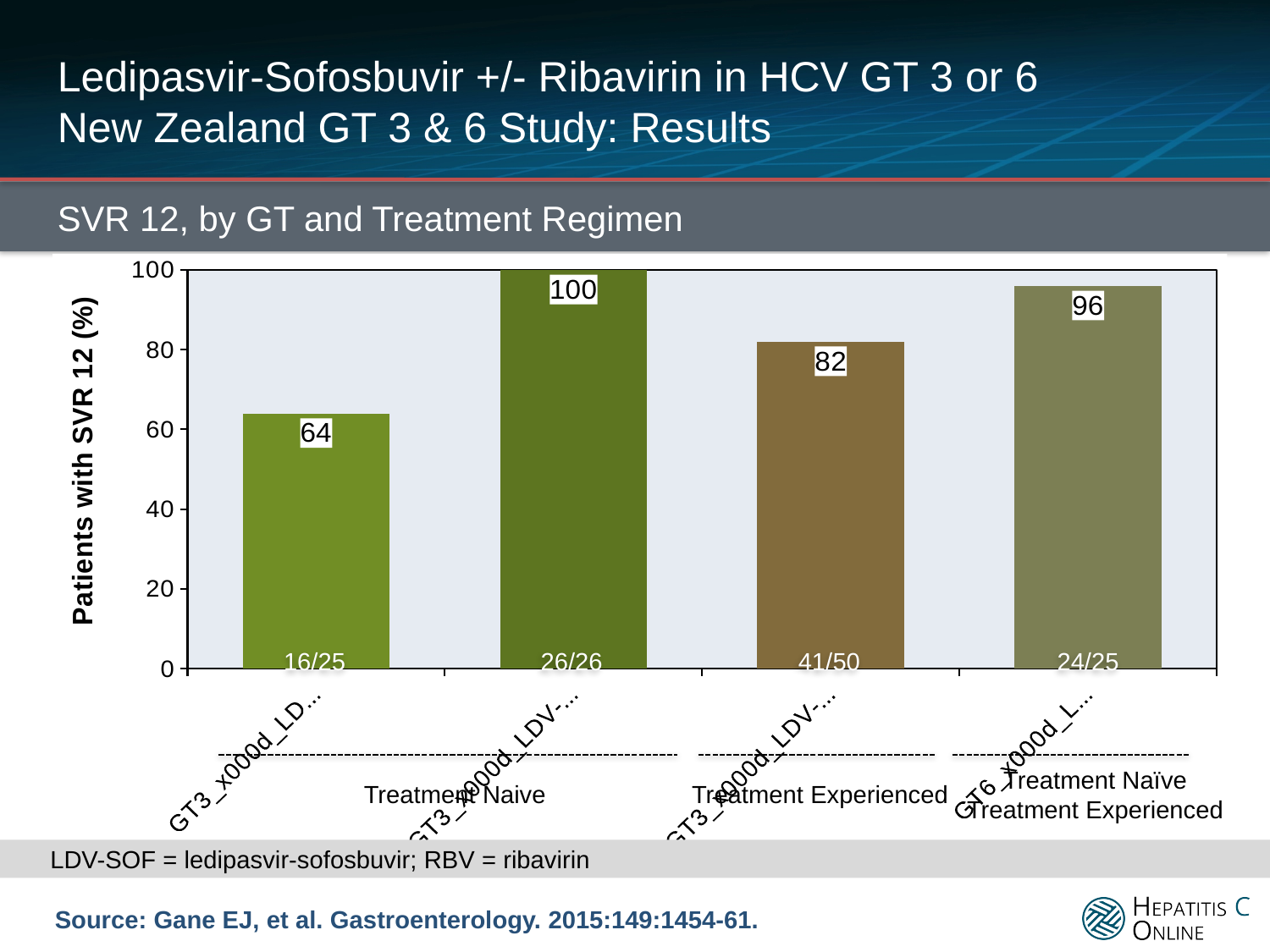
Which bar has the lowest value, by position from the left? The first bar (64) What is the value shown on the third bar from the left? 82 What is the label of the y-axis? Patients with SVR 12 (%) What is the value shown on the second bar from the left? 100 What is the value shown on the fourth (rightmost) bar? 96 What is the value shown on the first (leftmost) bar of the chart? 64 Which bar has the highest value, by position from the left? The second bar (100) What type of chart is shown on the slide? Bar chart How many bars are plotted in the chart? 4 What fraction is printed at the base of the bar labeled 82? 41/50 Which is larger, the value of the third bar or the fourth bar? The fourth bar (96) What is the difference between the value of the second bar (100) and the first bar (64)? 36